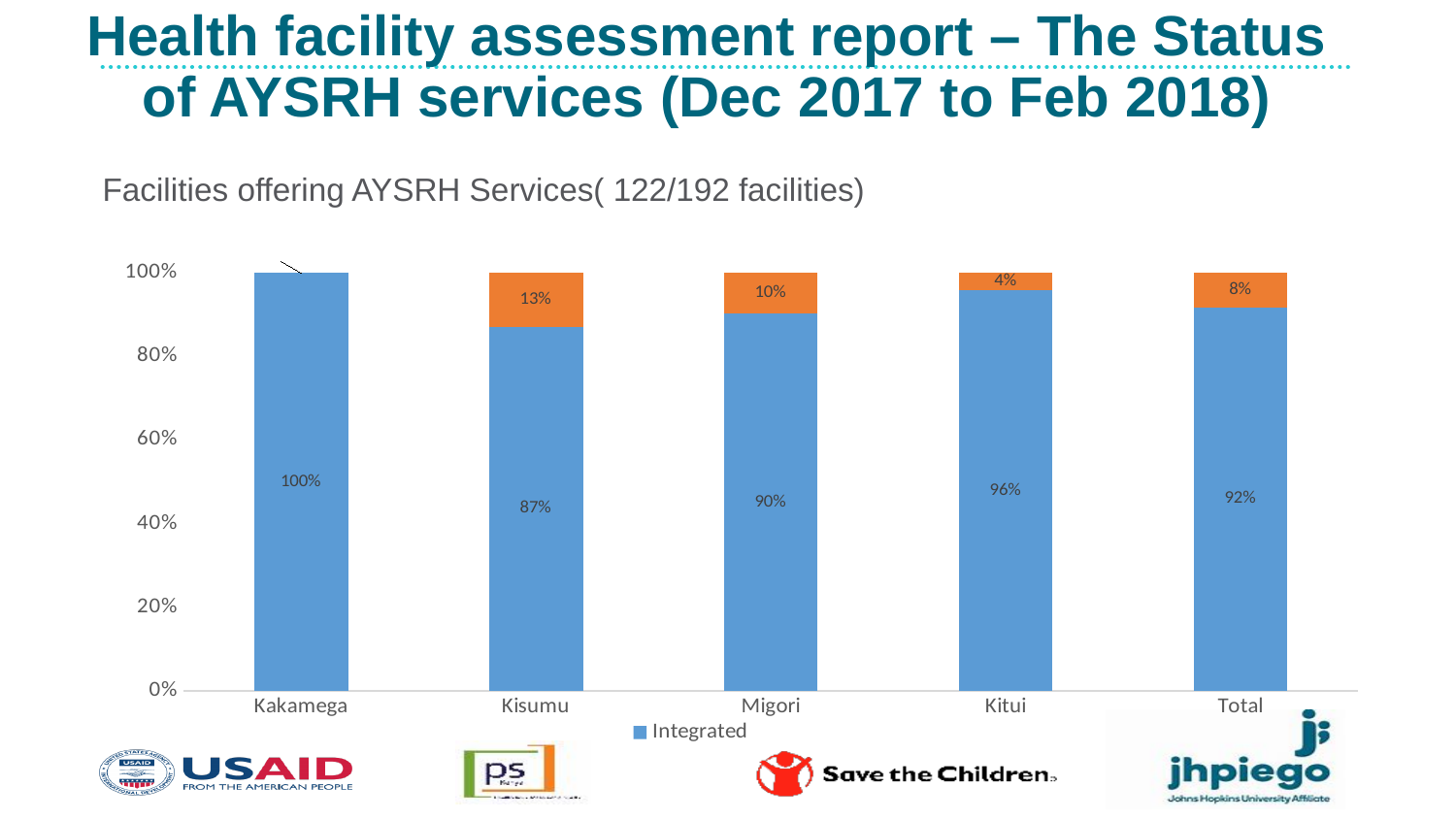
What is the value of the orange segment for Migori? 10% What is the title shown above the chart? Facilities offering AYSRH Services( 122/192 facilities) How many categories are shown on the x axis? 5 Which category has the lowest Integrated value? Kisumu What is the Integrated value for Total? 92% What kind of chart is shown on the slide? Stacked bar chart What is the Integrated value for Kitui? 96% What is the difference between the Integrated values for Kitui and Kisumu? 9% What is the Integrated value for Kisumu? 87% Which has a larger Integrated value, Migori or Kitui? Kitui Which category has the highest Integrated value? Kakamega How many series does the legend list? 1